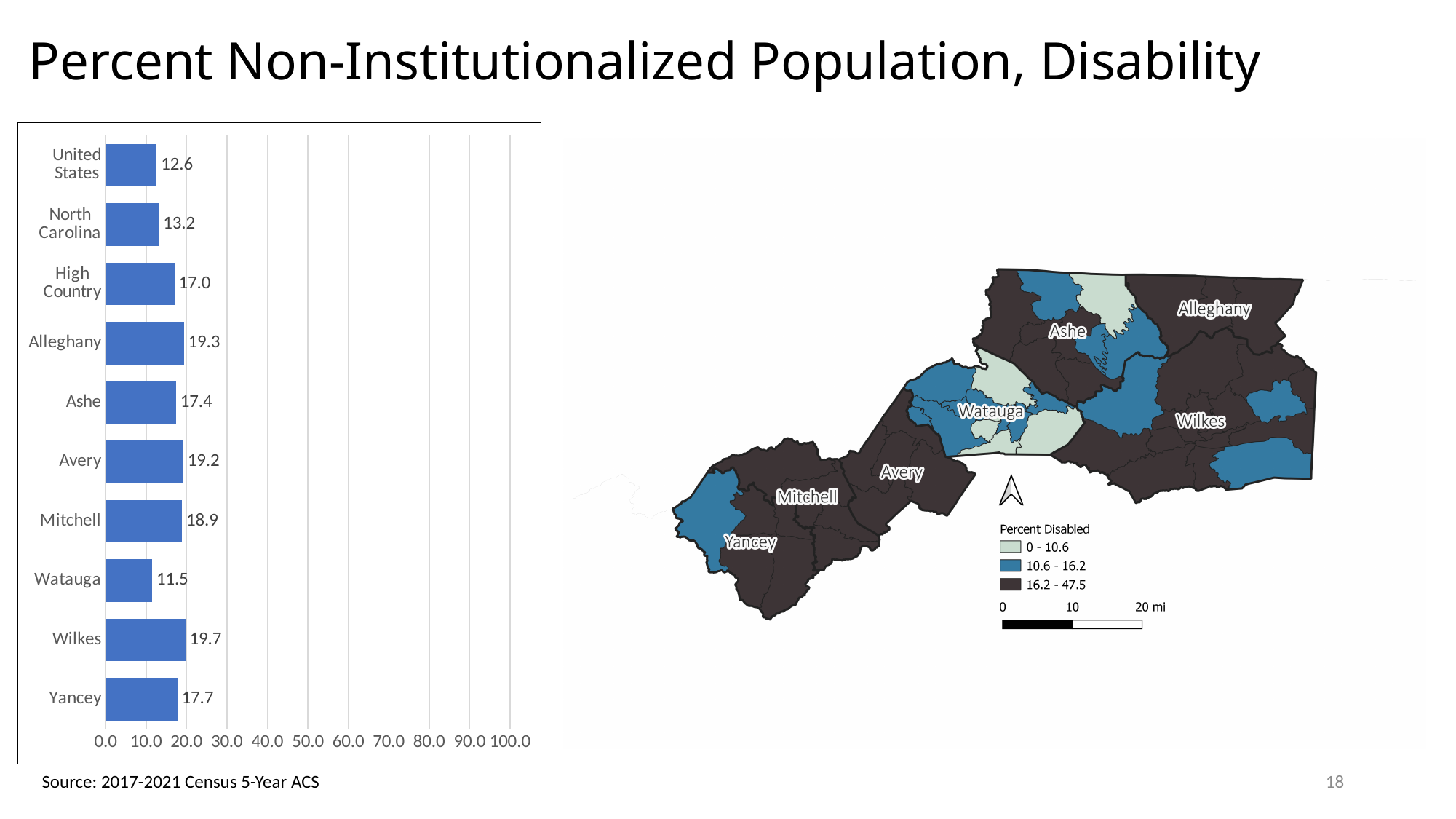
What is the value for Watauga in the bar chart? 11.5 Which category has the highest value in the bar chart? Wilkes Is the value for Alleghany in the bar chart greater or less than 10.0? greater Which category has the lowest value in the bar chart? Watauga What is the difference between the values for North Carolina and the United States in the bar chart? 0.6 What is the value for the United States in the bar chart? 12.6 What is the value for High Country in the bar chart? 17.0 What is the difference between the values for Wilkes and Watauga in the bar chart? 8.2 In the bar chart, which is larger, the value for Avery or the value for Mitchell? Avery How many categories are shown in the bar chart? 10 What kind of chart is shown on the left of the slide? Bar chart What is the value for Wilkes in the bar chart? 19.7